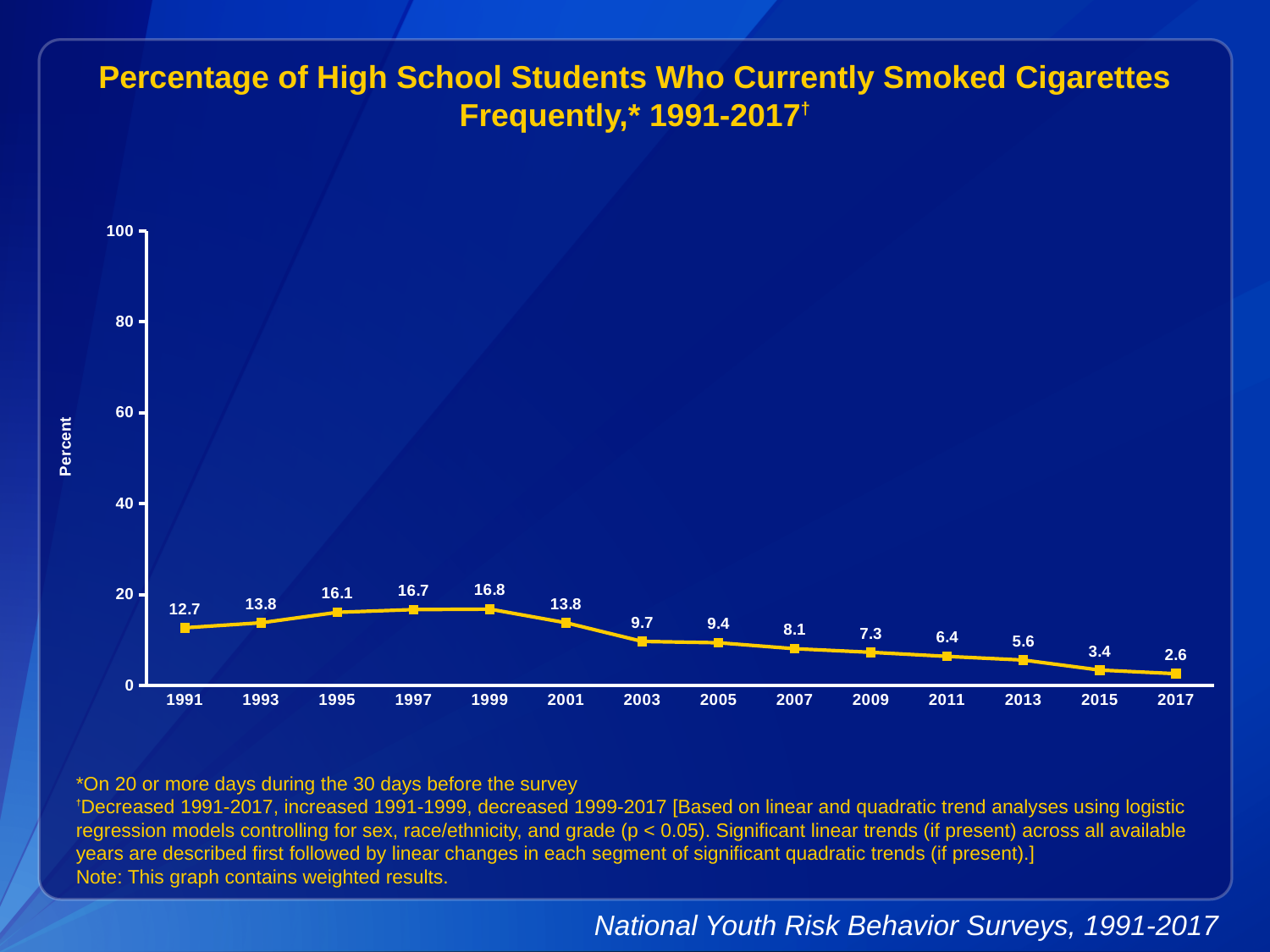
What was the percentage of high school students who currently smoked cigarettes frequently in 1991? 12.7 What is the difference between the values for 1999 and 2017? 14.2 Do the values rise or fall from 1999 to 2017? fall What value is shown for 2003? 9.7 Which year has the larger value, 1995 or 2001? 1995 Which year has the highest value on the chart? 1999 Is the value for 1997 greater or less than 20? less What value is shown for 2017? 2.6 How many years are plotted on the x axis? 14 What is the label on the y axis? Percent What kind of chart is shown on the slide? line chart Which year has the lowest value on the chart? 2017